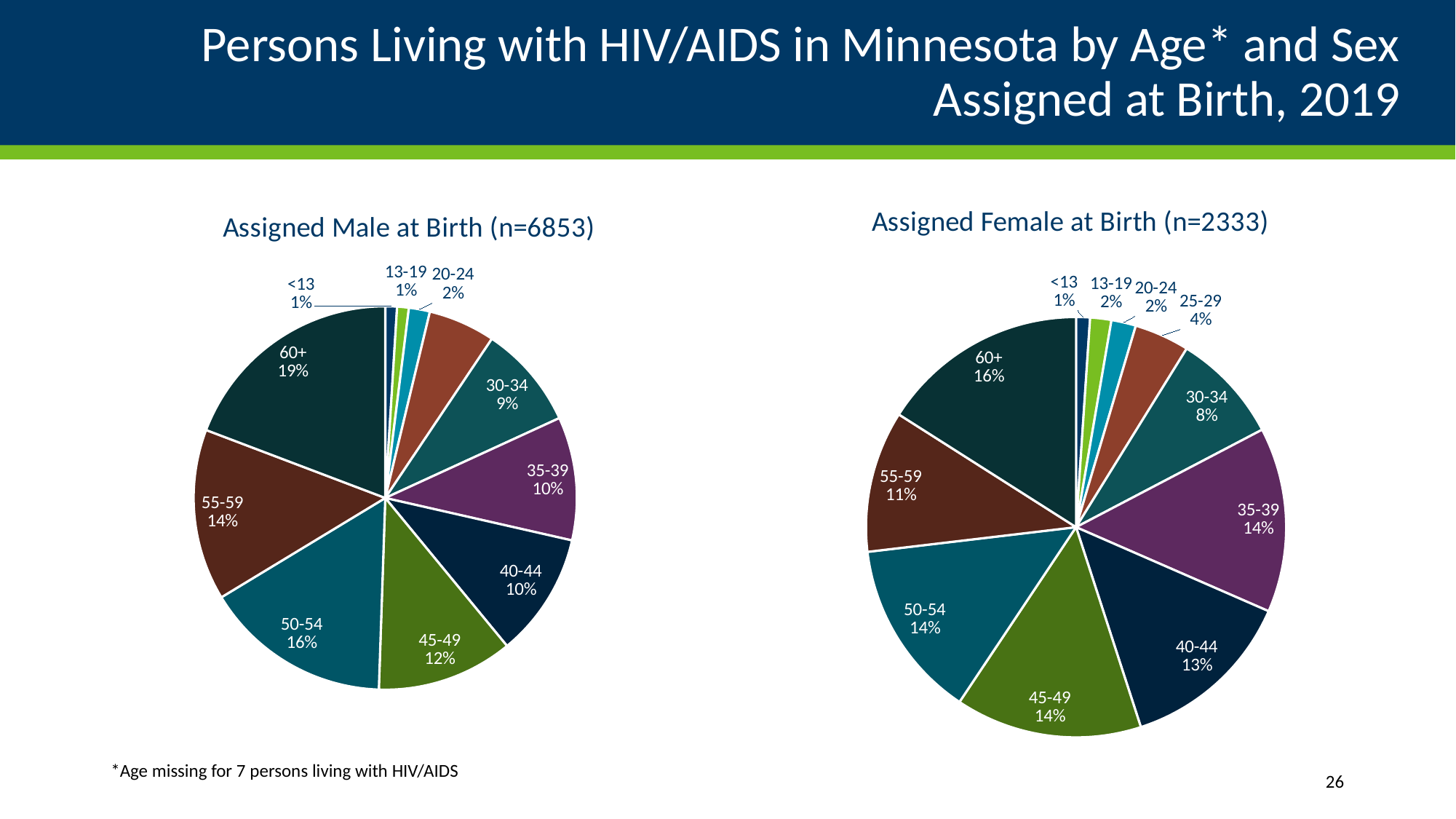
How many age-group slices are labeled in the Assigned Female at Birth pie chart? 11 In the Assigned Female at Birth pie chart, what share is the 55-59 age group? 11% What type of chart is used for the Assigned Male at Birth data? Pie chart In the Assigned Male at Birth pie chart, what share is the 50-54 age group? 16% In the Assigned Male at Birth pie chart, which age group has the largest share? 60+ What is the n value shown in the title of the Assigned Female at Birth chart? 2333 In the Assigned Male at Birth pie chart, what is the difference between the shares for 60+ and 30-34? 10% In the Assigned Female at Birth pie chart, which age group has the smallest share? <13 In the Assigned Female at Birth pie chart, what share is the 25-29 age group? 4% In the Assigned Male at Birth pie chart, what share is the 60+ age group? 19% In the Assigned Female at Birth pie chart, which is larger, the share for 40-44 or the share for 55-59? 40-44 In the Assigned Female at Birth pie chart, which age group has the largest share? 60+